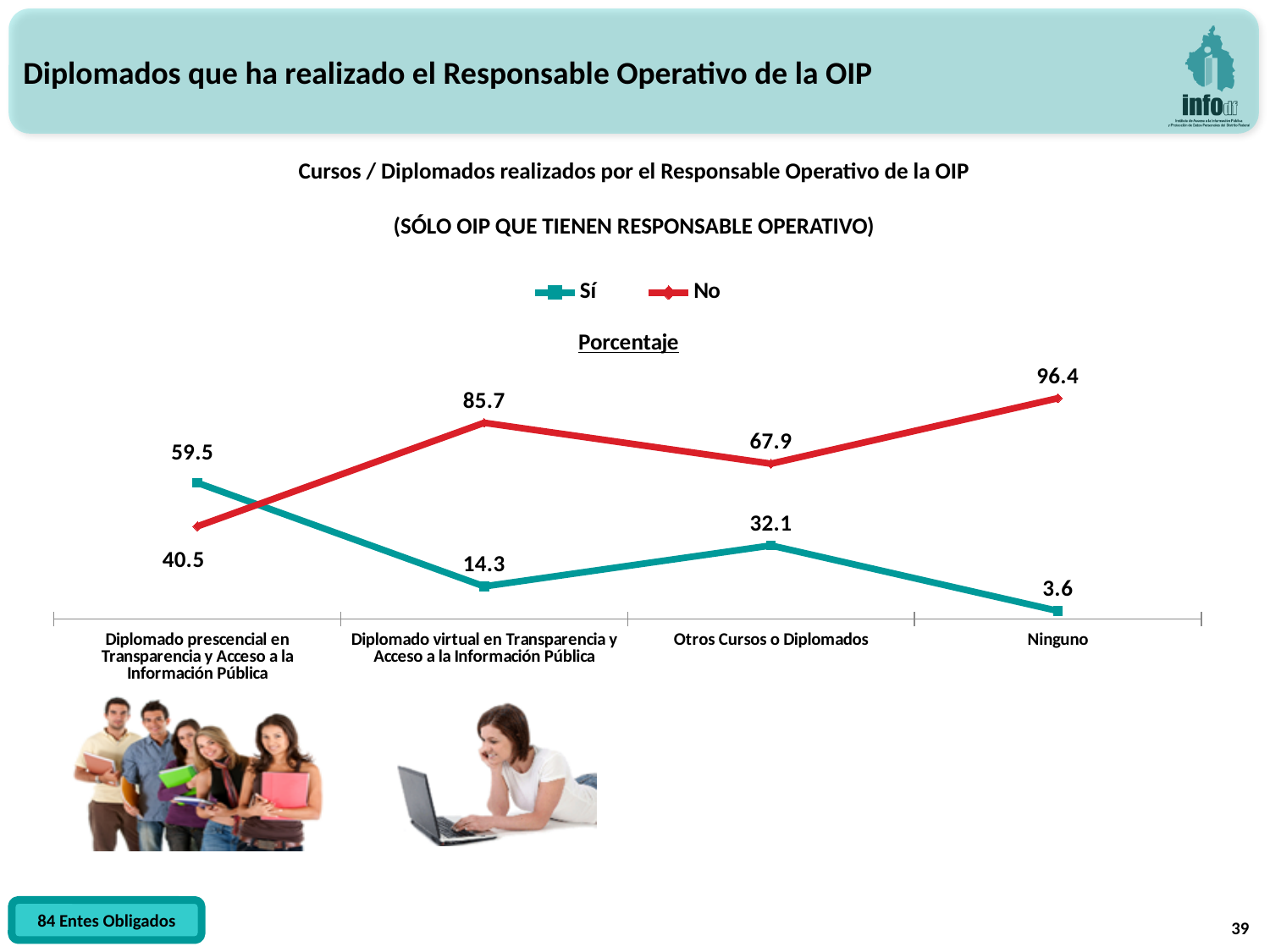
What kind of chart is shown on the slide? Line chart How many series does the legend list? 2 How many categories are shown on the x axis? 4 What colour is the line for the "No" series? Red Which is larger for "Diplomado prescencial en Transparencia y Acceso a la Información Pública": the "Sí" value or the "No" value? Sí Which category has the lowest value in the "Sí" series? Ninguno What is the value of the "No" series for "Diplomado prescencial en Transparencia y Acceso a la Información Pública"? 40.5 Which category has the highest value in the "No" series? Ninguno What is the value of the "Sí" series for "Otros Cursos o Diplomados"? 32.1 What is the difference between the "No" and "Sí" values for "Ninguno"? 92.8 What is the value of the "No" series for "Diplomado virtual en Transparencia y Acceso a la Información Pública"? 85.7 What is the value of the "Sí" series for "Ninguno"? 3.6